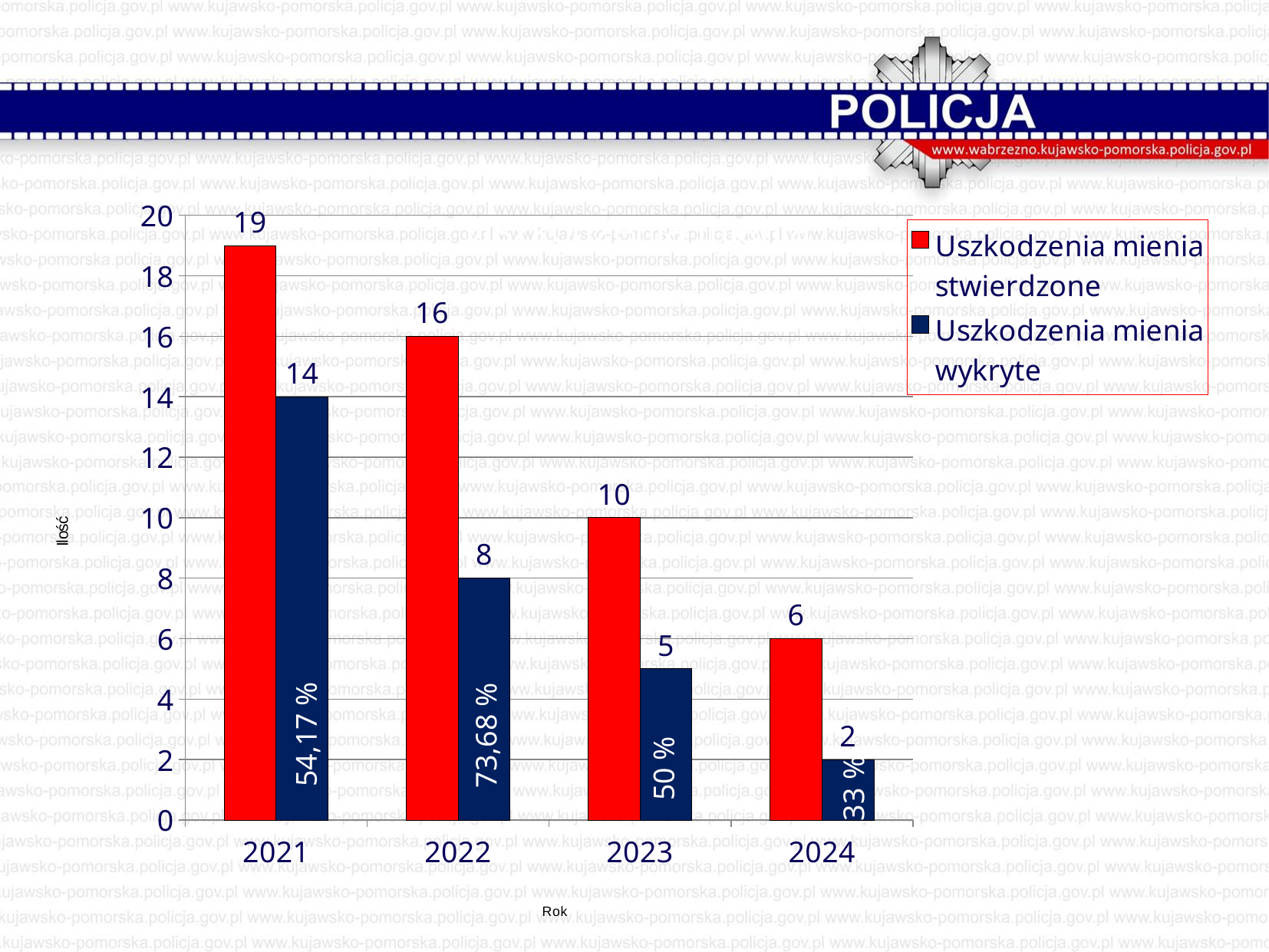
In which year is Uszkodzenia mienia wykryte lowest? 2024 What is the value of Uszkodzenia mienia stwierdzone for 2021? 19 What is the value of Uszkodzenia mienia wykryte for 2024? 2 Which is larger in 2023: Uszkodzenia mienia stwierdzone or Uszkodzenia mienia wykryte? Uszkodzenia mienia stwierdzone How many years are shown on the x axis? 4 In which year is Uszkodzenia mienia stwierdzone highest? 2021 What is the difference between Uszkodzenia mienia stwierdzone and Uszkodzenia mienia wykryte in 2022? 8 What percentage is printed inside the Uszkodzenia mienia wykryte bar for 2022? 73,68 % What kind of chart is shown on the slide? bar chart How many series does the legend list? 2 Do the values of Uszkodzenia mienia stwierdzone rise or fall from 2021 to 2024? fall What is the value of Uszkodzenia mienia wykryte for 2022? 8